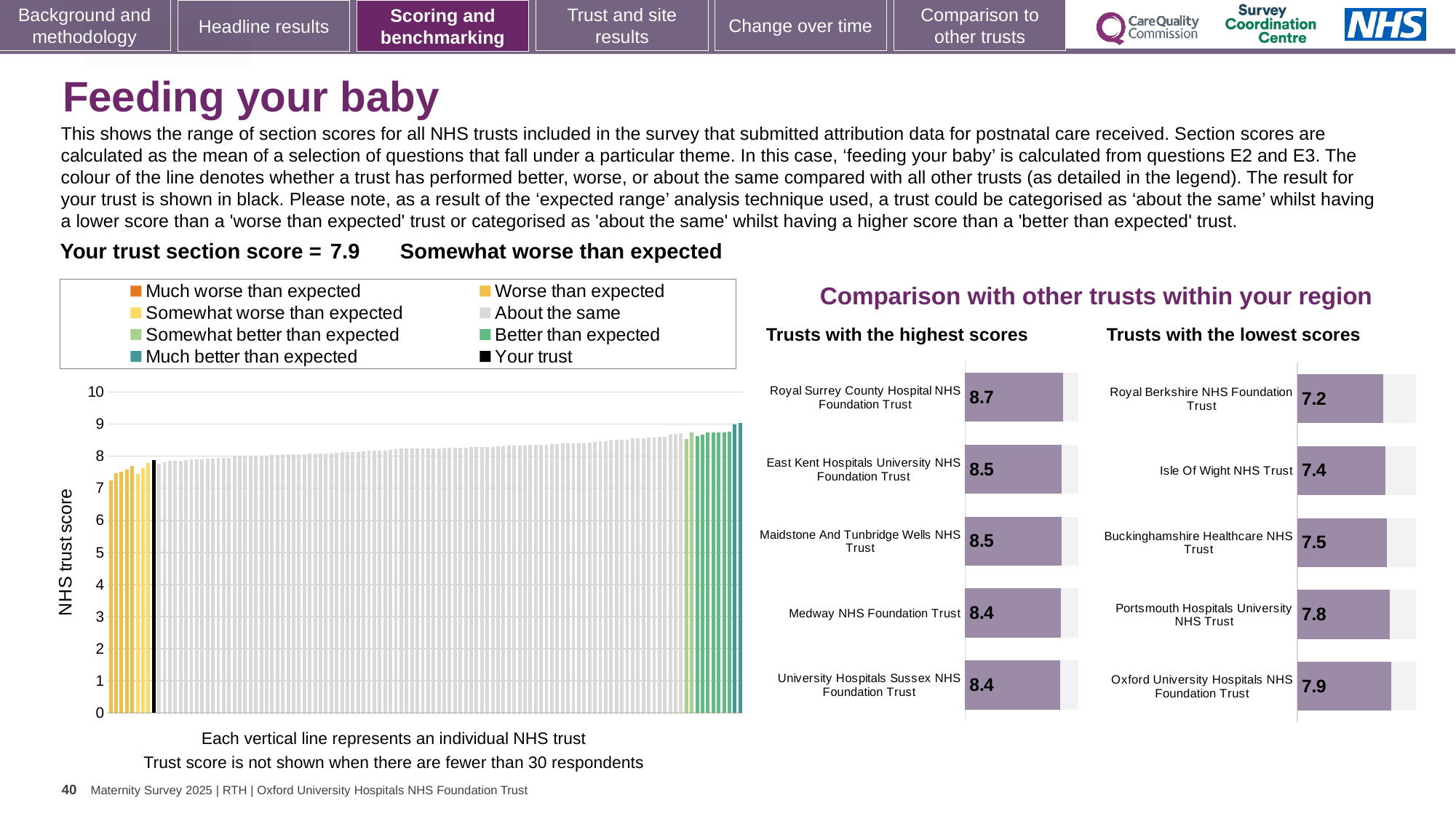
In the 'Trusts with the lowest scores' chart, what is the difference between the scores of Oxford University Hospitals NHS Foundation Trust and Royal Berkshire NHS Foundation Trust? 0.7 In the 'Trusts with the highest scores' chart, which trust has the highest score? Royal Surrey County Hospital NHS Foundation Trust How many trusts are shown in the 'Trusts with the highest scores' chart? 5 In the 'Trusts with the lowest scores' chart, which trust has the lowest score? Royal Berkshire NHS Foundation Trust In the 'Trusts with the lowest scores' chart, what is the score for Oxford University Hospitals NHS Foundation Trust? 7.9 In the 'Trusts with the lowest scores' chart, which has the higher score: Isle Of Wight NHS Trust or Buckinghamshire Healthcare NHS Trust? Buckinghamshire Healthcare NHS Trust What kind of chart is the 'NHS trust score' chart on the left of the slide? Bar chart In the 'Trusts with the highest scores' chart, what is the difference between the scores of Royal Surrey County Hospital NHS Foundation Trust and Medway NHS Foundation Trust? 0.3 In the 'NHS trust score' chart on the left, is the value of the black bar (your trust) greater or less than 7? greater In the 'Trusts with the lowest scores' chart, what is the score for Royal Berkshire NHS Foundation Trust? 7.2 In the 'Trusts with the highest scores' chart, what is the score for Royal Surrey County Hospital NHS Foundation Trust? 8.7 In the 'NHS trust score' chart on the left, do the values rise or fall from left to right? Rise